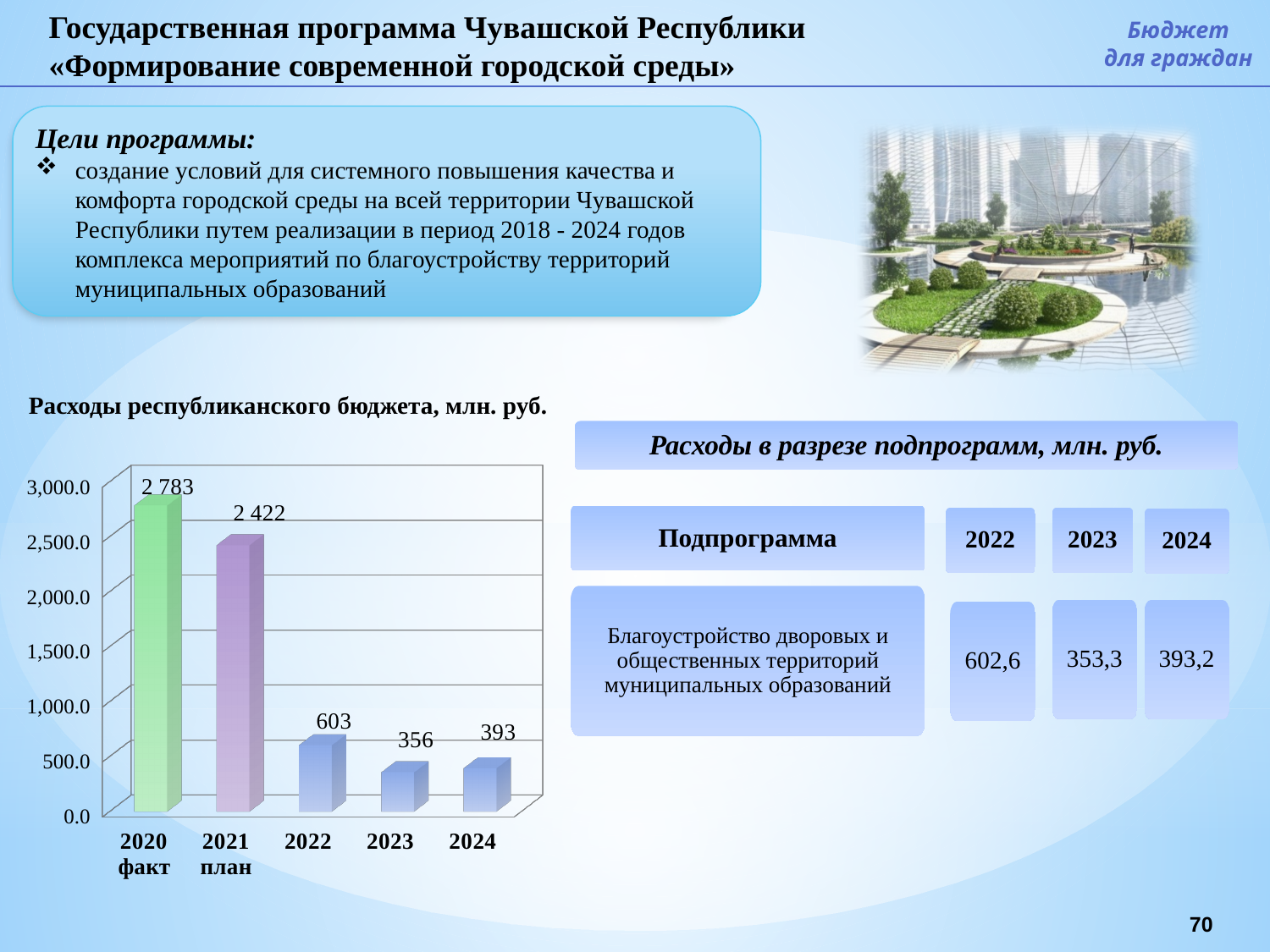
What is the value for 2022 in the chart? 603 Which is larger, the value for 2023 or the value for 2024? 2024 Which category has the highest value in the chart? 2020 факт How many categories are shown on the x axis of the chart? 5 What is the difference between the values for 2022 and 2023? 247 What kind of chart is shown on the slide? bar chart Which category has the lowest value in the chart? 2023 What is the title of the chart on the slide? Расходы республиканского бюджета, млн. руб. What is the value for 2023 in the chart? 356 What is the value for 2021 план in the chart? 2 422 What is the value for 2020 факт in the chart 'Расходы республиканского бюджета, млн. руб.'? 2 783 What is the difference between the values for 2020 факт and 2021 план? 361